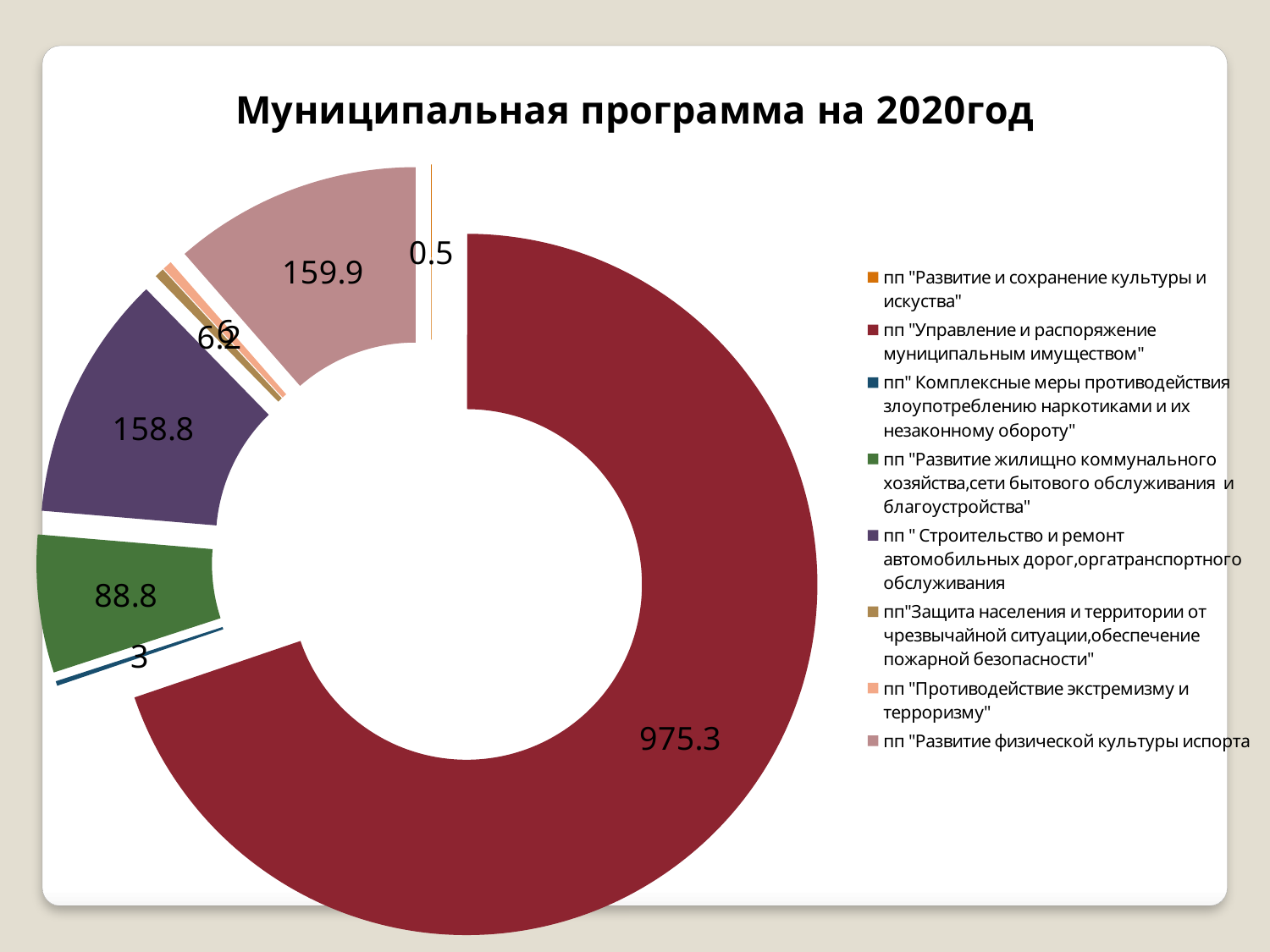
What is the value for пп "Комплексные меры противодействия злоупотреблению наркотиками и их незаконному обороту"? 3 How many entries does the chart legend list? 8 What is the difference between the values for пп "Развитие физической культуры испорта" and пп "Развитие жилищно коммунального хозяйства,сети бытового обслуживания и благоустройства"? 71.1 What is the title of the chart? Муниципальная программа на 2020год What is the value for пп "Управление и распоряжение муниципальным имуществом"? 975.3 What is the value for пп "Развитие физической культуры испорта"? 159.9 Which program has the smallest value in the chart? пп "Развитие и сохранение культуры и искуства" What is the value for пп "Развитие и сохранение культуры и искуства"? 0.5 Which program has the largest value in the chart? пп "Управление и распоряжение муниципальным имуществом" What is the value for пп "Строительство и ремонт автомобильных дорог,оргатранспортного обслуживания"? 158.8 What is the value for пп "Развитие жилищно коммунального хозяйства,сети бытового обслуживания и благоустройства"? 88.8 What kind of chart is shown on the slide? doughnut (pie) chart